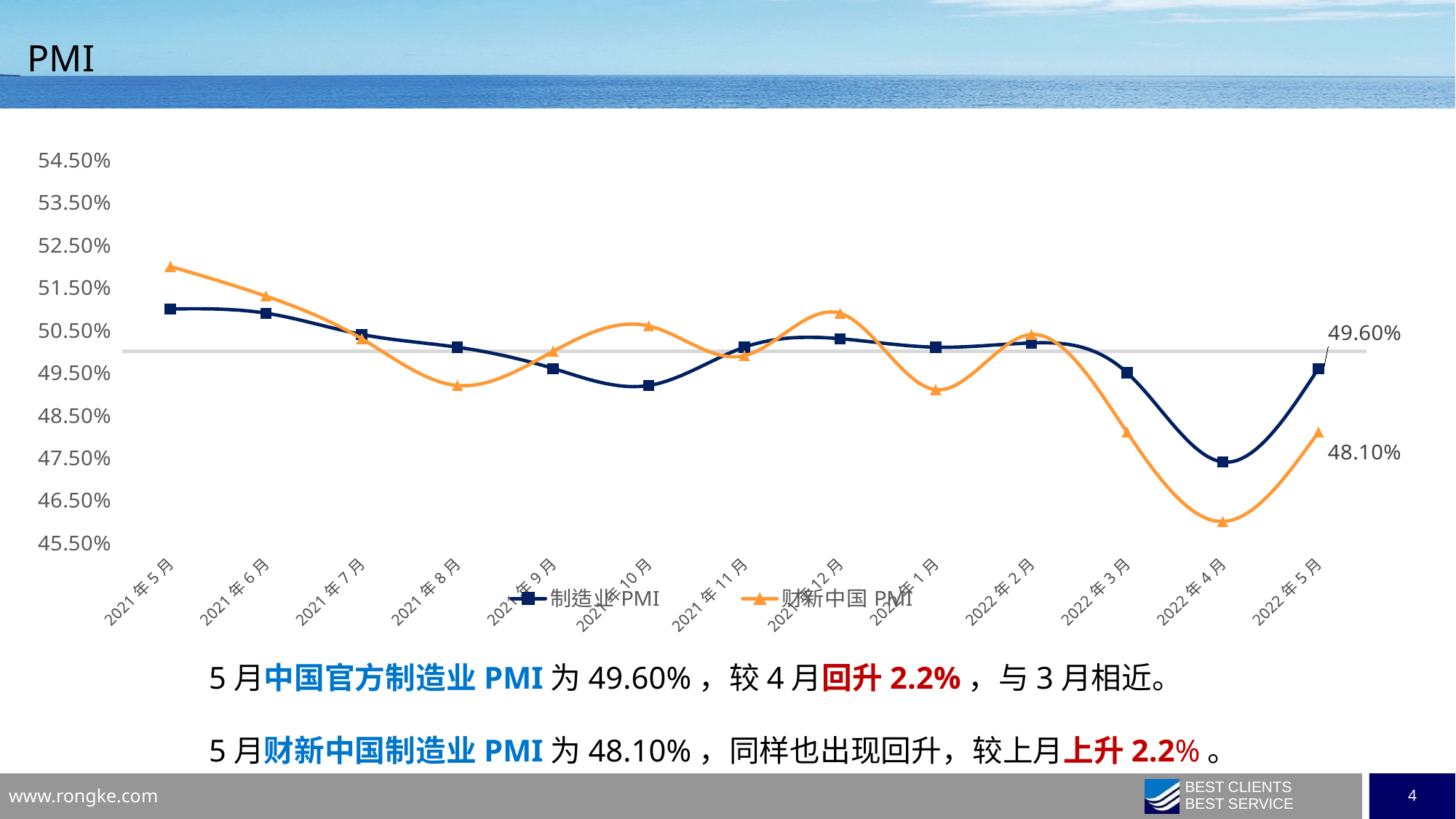
In which month is 财新中国 PMI at its lowest? 2022年4月 Is the value for 制造业PMI in 2022年4月 greater or less than 48.50%? less How many months are plotted along the x axis? 13 What is the value of 财新中国 PMI for 2022年5月? 48.10% In 2022年5月, which series has the larger value, 制造业PMI or 财新中国 PMI? 制造业PMI Is the value for 财新中国 PMI in 2022年4月 greater or less than 46.50%? less What kind of chart is shown on the slide? line chart In which month is 财新中国 PMI at its highest? 2021年5月 How many series does the legend list? 2 What is the value of 制造业PMI for 2022年5月? 49.60% What is the difference between 制造业PMI and 财新中国 PMI in 2022年5月? 1.50% In which month is 制造业PMI at its lowest? 2022年4月